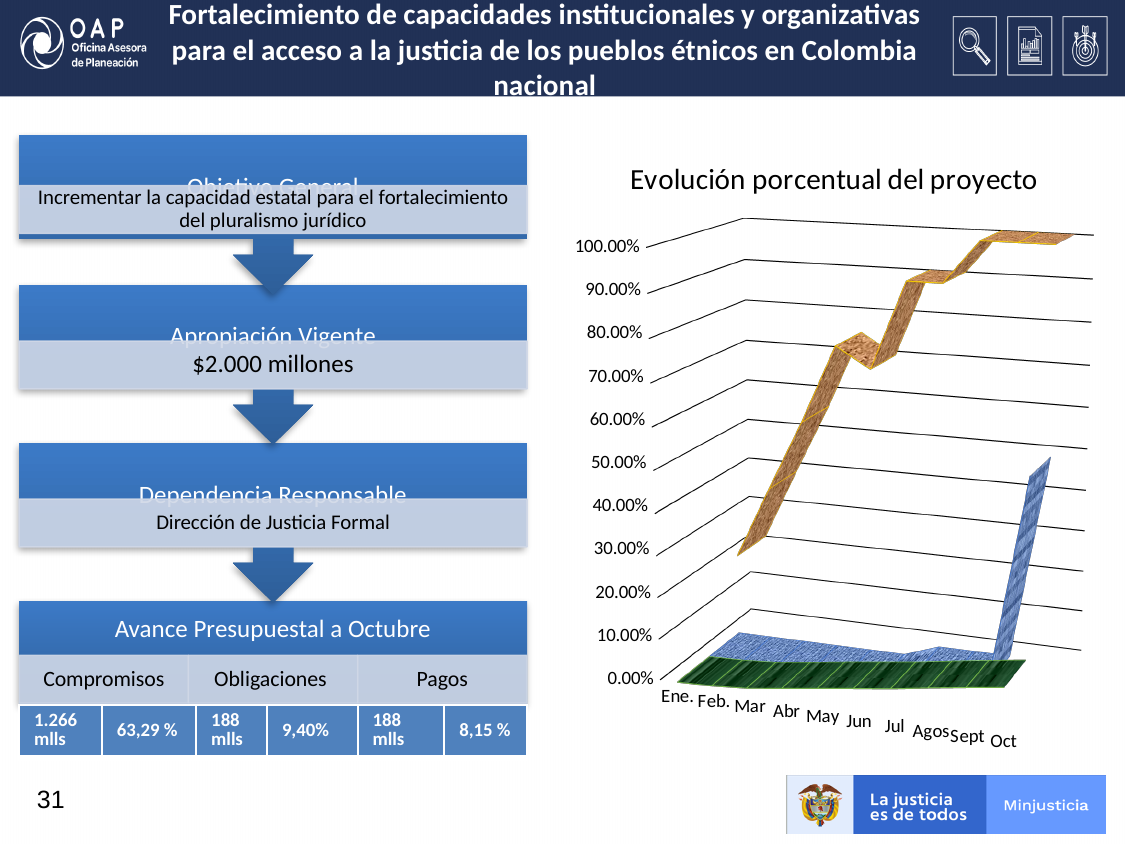
In the "Evolución porcentual del proyecto" chart, which series has the higher value for May, the brown series or the blue series? the brown series In the "Evolución porcentual del proyecto" chart, in which month does the lower (blue) series reach its highest value? Oct How many months are shown on the x axis of the "Evolución porcentual del proyecto" chart? 10 What is the title of the chart on the right side of the slide? Evolución porcentual del proyecto In the "Evolución porcentual del proyecto" chart, is the value of the upper (brown) series for Ene. greater or less than 50.00%? less In the "Evolución porcentual del proyecto" chart, does the upper (brown) series generally rise or fall from Ene. to Oct? rise In the "Evolución porcentual del proyecto" chart, what is the first month on the x axis? Ene. In the "Evolución porcentual del proyecto" chart, is the value of the upper (brown) series for Oct greater or less than 80.00%? greater What kind of chart is "Evolución porcentual del proyecto"? line chart In the "Evolución porcentual del proyecto" chart, is the value of the lower (blue) series for Oct greater or less than 30.00%? greater